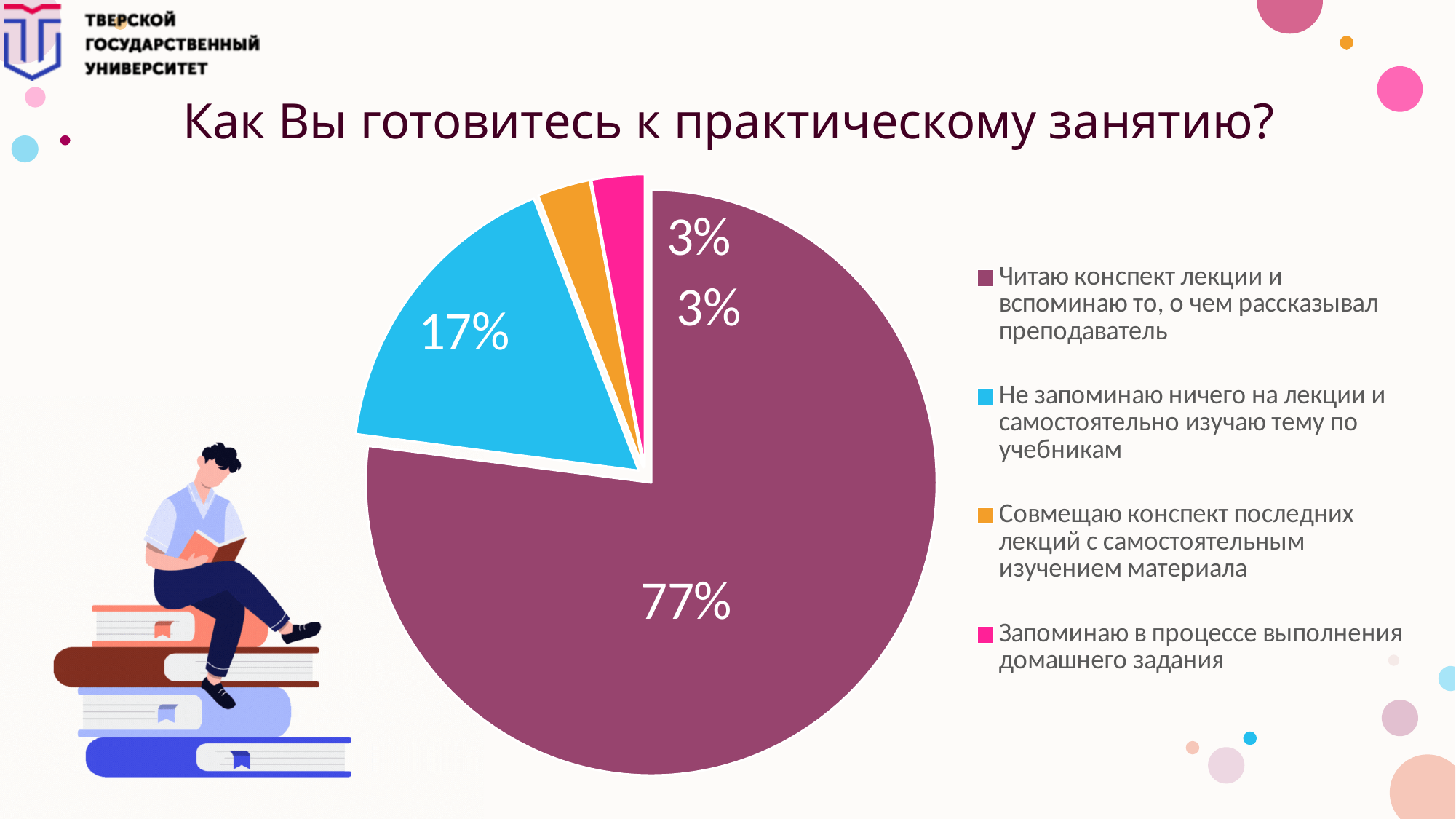
Which answer option has the largest share of the pie? Читаю конспект лекции и вспоминаю то, о чем рассказывал преподаватель What colour is the slice for "Запоминаю в процессе выполнения домашнего задания"? Pink How many entries does the legend list? 4 What share of respondents answered "Совмещаю конспект последних лекций с самостоятельным изучением материала"? 3% How many slices does the pie chart have? 4 What share of respondents answered "Запоминаю в процессе выполнения домашнего задания"? 3% What share of respondents answered "Читаю конспект лекции и вспоминаю то, о чем рассказывал преподаватель"? 77% What is the difference in percentage points between the "Читаю конспект лекции..." slice and the "Не запоминаю ничего на лекции..." slice? 60 percentage points What kind of chart is shown on the slide? Pie chart What share of respondents answered "Не запоминаю ничего на лекции и самостоятельно изучаю тему по учебникам"? 17% Which is larger: the share for "Не запоминаю ничего на лекции и самостоятельно изучаю тему по учебникам" or the share for "Совмещаю конспект последних лекций с самостоятельным изучением материала"? Не запоминаю ничего на лекции и самостоятельно изучаю тему по учебникам What is the title of the chart on the slide? Как Вы готовитесь к практическому занятию?